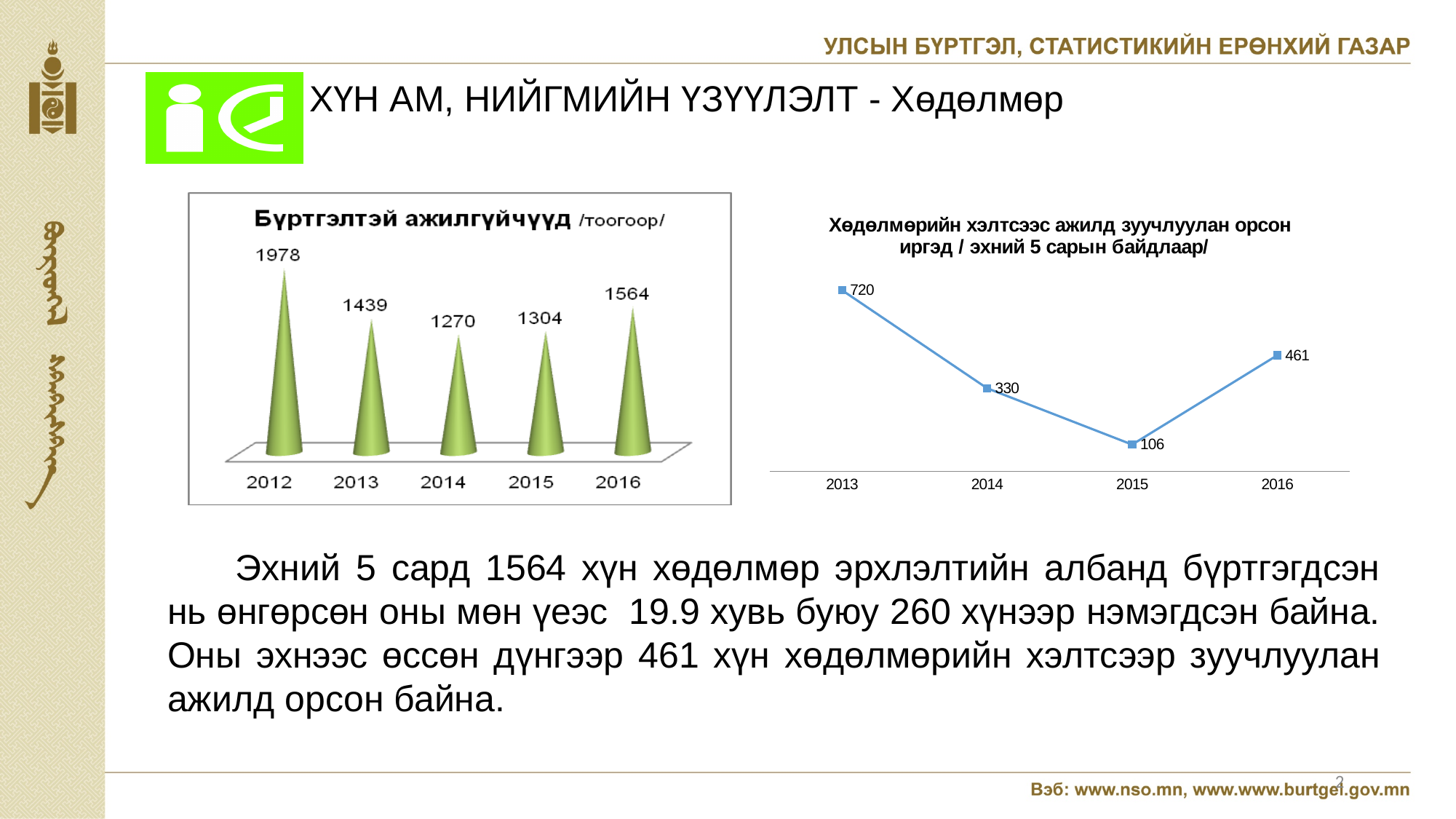
What kind of chart is the right chart (Хөдөлмөрийн хэлтсээс ажилд зуучлуулан орсон иргэд)? line chart In the left chart (Бүртгэлтэй ажилгүйчүүд), what is the value for 2015? 1304 In the left chart (Бүртгэлтэй ажилгүйчүүд), which year has the highest value? 2012 In the left chart (Бүртгэлтэй ажилгүйчүүд), what is the value for 2012? 1978 In the right chart (Хөдөлмөрийн хэлтсээс ажилд зуучлуулан орсон иргэд), what is the difference between the 2013 and 2016 values? 259 In the right chart (Хөдөлмөрийн хэлтсээс ажилд зуучлуулан орсон иргэд), what is the value for 2014? 330 In the left chart (Бүртгэлтэй ажилгүйчүүд), what is the difference between the 2016 and 2015 values? 260 In the right chart (Хөдөлмөрийн хэлтсээс ажилд зуучлуулан орсон иргэд), which year has the lowest value? 2015 In the left chart (Бүртгэлтэй ажилгүйчүүд), how many years are shown? 5 In the right chart (Хөдөлмөрийн хэлтсээс ажилд зуучлуулан орсон иргэд), do the values rise or fall from 2013 to 2015? fall In the left chart (Бүртгэлтэй ажилгүйчүүд), which year has the lowest value? 2014 In the left chart (Бүртгэлтэй ажилгүйчүүд), is the value for 2013 larger or smaller than the value for 2014? larger